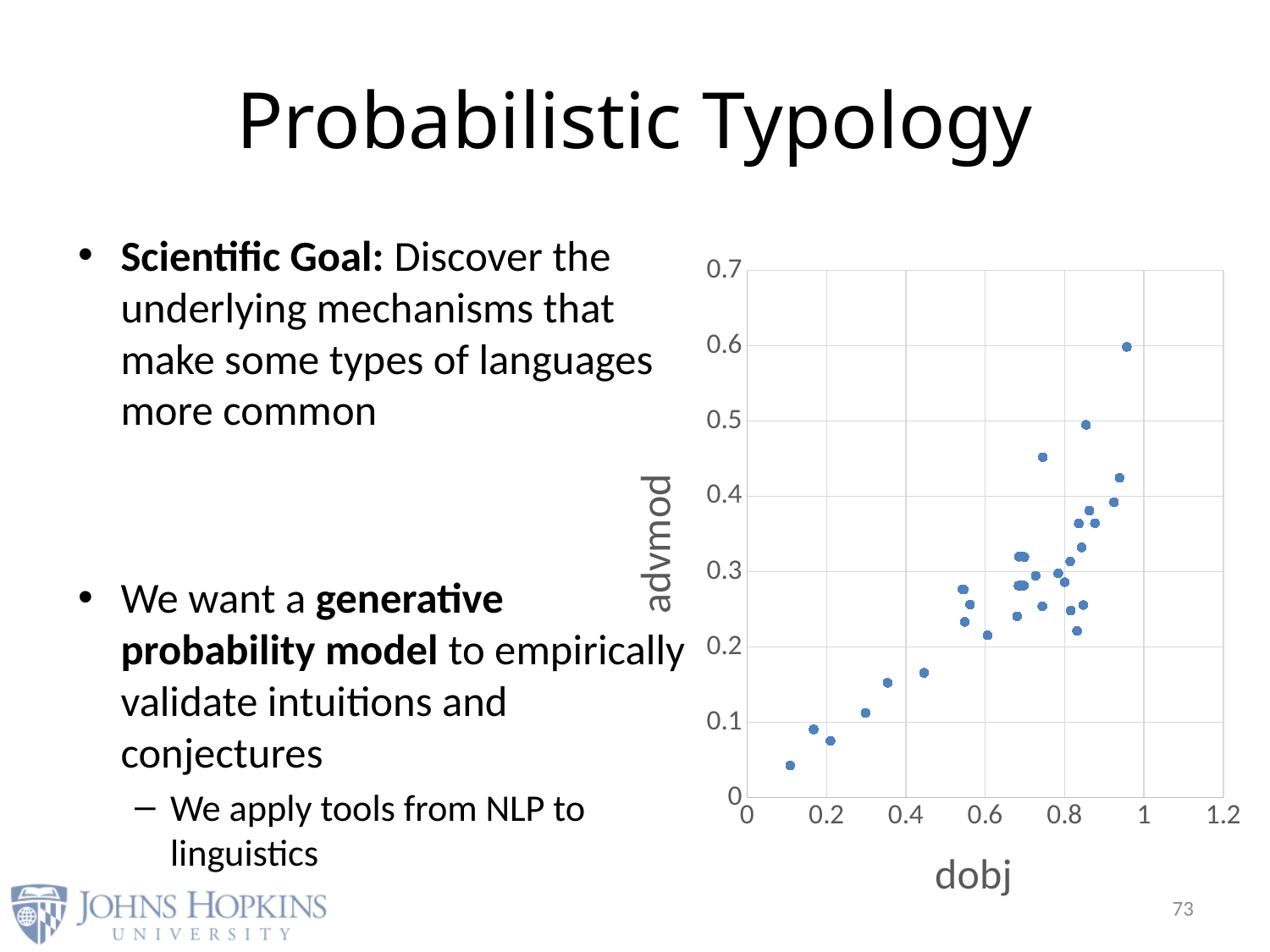
Is the highest advmod value in the chart greater or less than 0.5? greater What is the label of the x axis of the chart? dobj Is the advmod value of the point with the lowest dobj greater or less than 0.1? less Is the advmod value of the point with the highest dobj greater or less than 0.5? greater What kind of chart is shown on the slide? scatter plot Which has the larger advmod value: the point with the highest dobj or the point with the lowest dobj? the point with the highest dobj What is the label of the y axis of the chart? advmod Do the advmod values generally rise or fall as dobj increases along the x axis? rise How many points in the chart have a dobj value greater than 1? 0